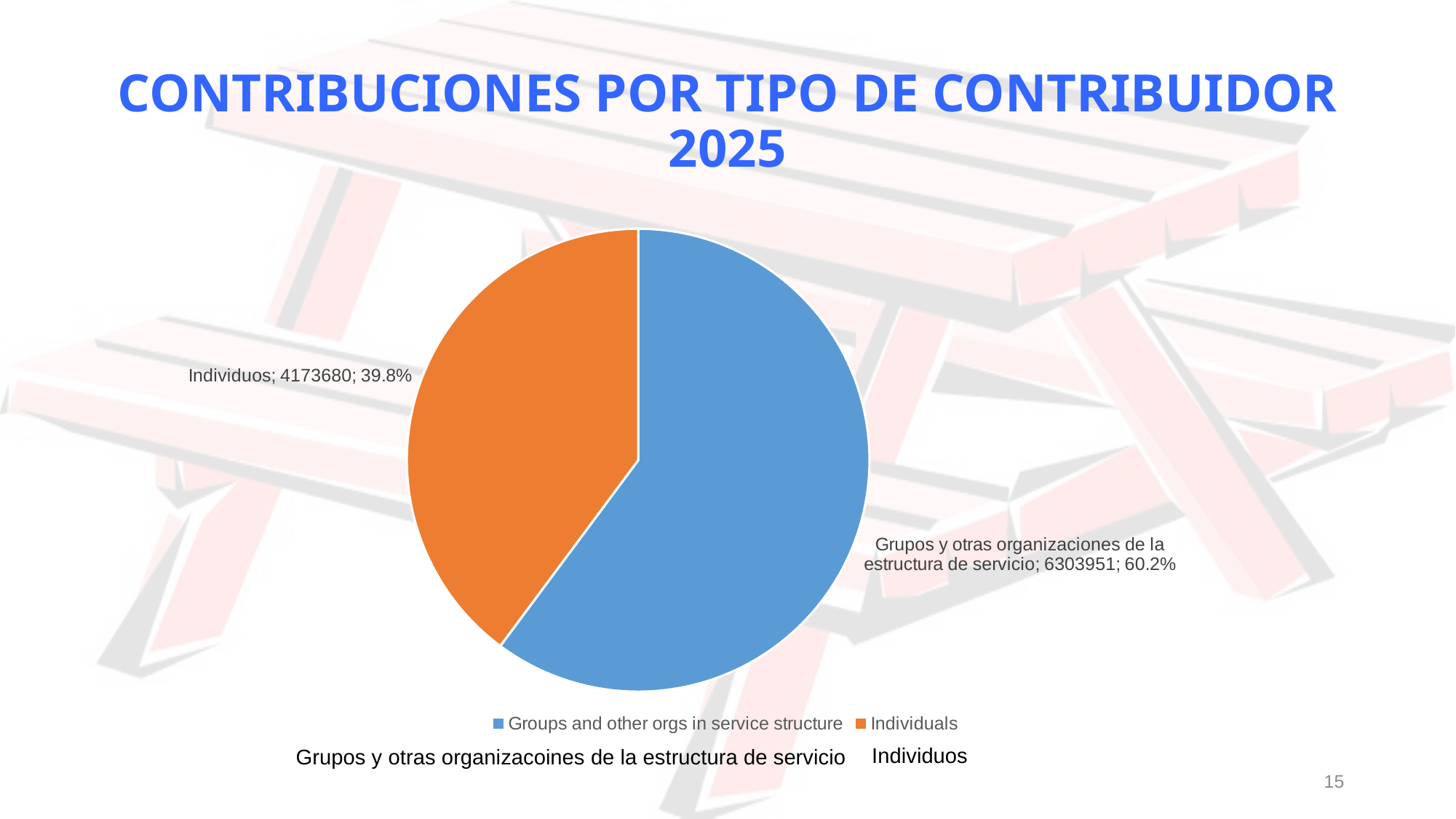
How many entries does the legend list? 2 What is the value for Individuos? 4173680 What is the difference between the value for Grupos y otras organizaciones de la estructura de servicio and the value for Individuos? 2130271 What share of the pie does the Grupos y otras organizaciones de la estructura de servicio slice represent? 60.2% Which category has the smallest slice of the pie? Individuos Which category has the largest slice of the pie? Grupos y otras organizaciones de la estructura de servicio What share of the pie does the Individuos slice represent? 39.8% What kind of chart is shown on the slide? Pie chart What is the value for Grupos y otras organizaciones de la estructura de servicio? 6303951 How many slices does the pie chart have? 2 What colour is the Individuals slice in the pie chart? Orange Which is larger, the value for Individuos or the value for Grupos y otras organizaciones de la estructura de servicio? Grupos y otras organizaciones de la estructura de servicio